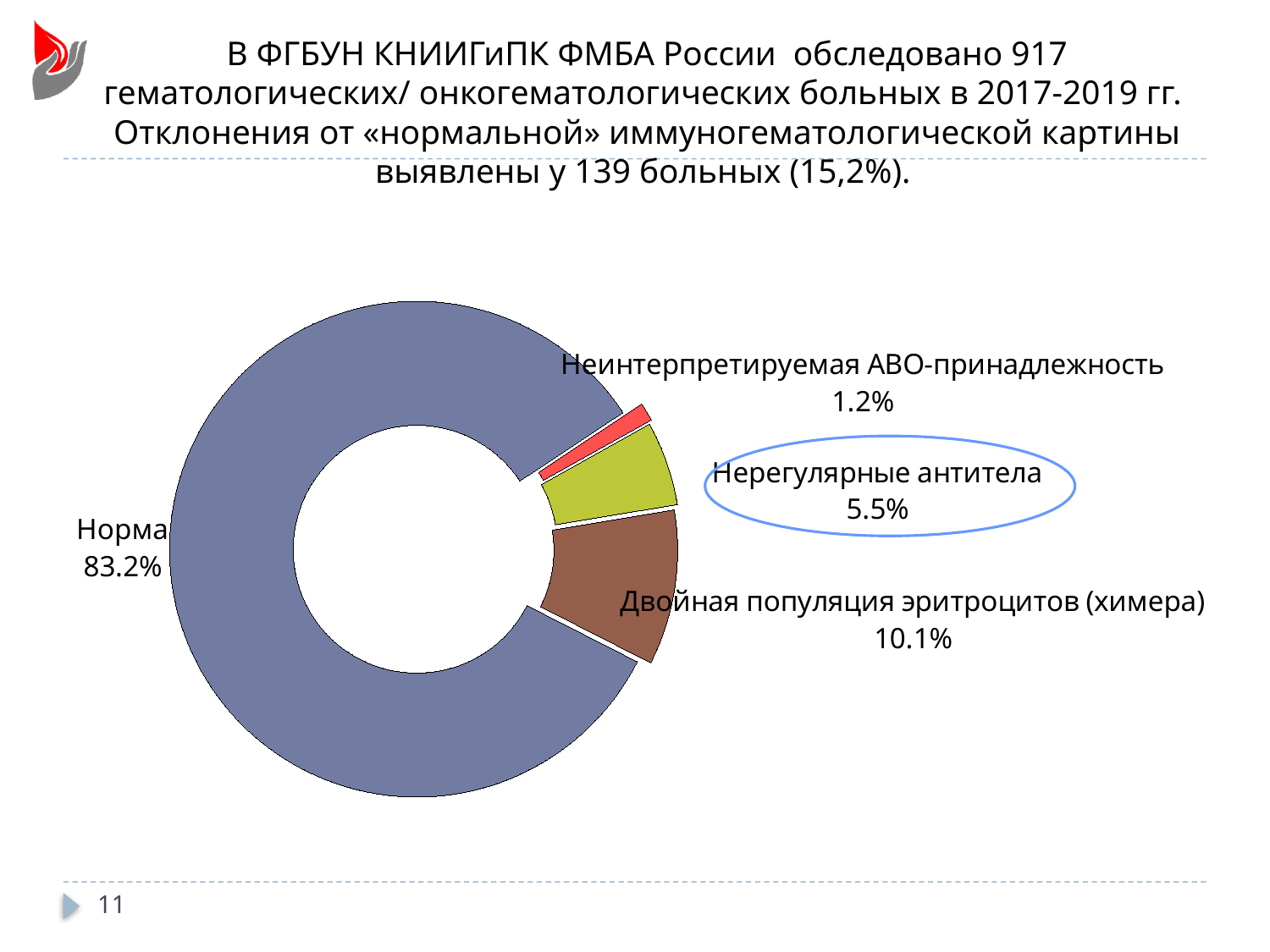
What share is shown for "Двойная популяция эритроцитов (химера)"? 10.1% Which category has the largest share? Норма What share is shown for "Неинтерпретируемая АВО-принадлежность"? 1.2% What is the difference between the shares for "Норма" and "Двойная популяция эритроцитов (химера)"? 73.1% What is the difference between the shares for "Двойная популяция эритроцитов (химера)" and "Нерегулярные антитела"? 4.6% What kind of chart is shown on the slide? Doughnut (pie) chart How many categories does the chart show? 4 Which category has the smallest share? Неинтерпретируемая АВО-принадлежность Which is larger: the share for "Нерегулярные антитела" or for "Двойная популяция эритроцитов (химера)"? Двойная популяция эритроцитов (химера) Which category label is circled on the slide? Нерегулярные антитела What share of the chart is labelled "Норма"? 83.2% What share is shown for "Нерегулярные антитела"? 5.5%